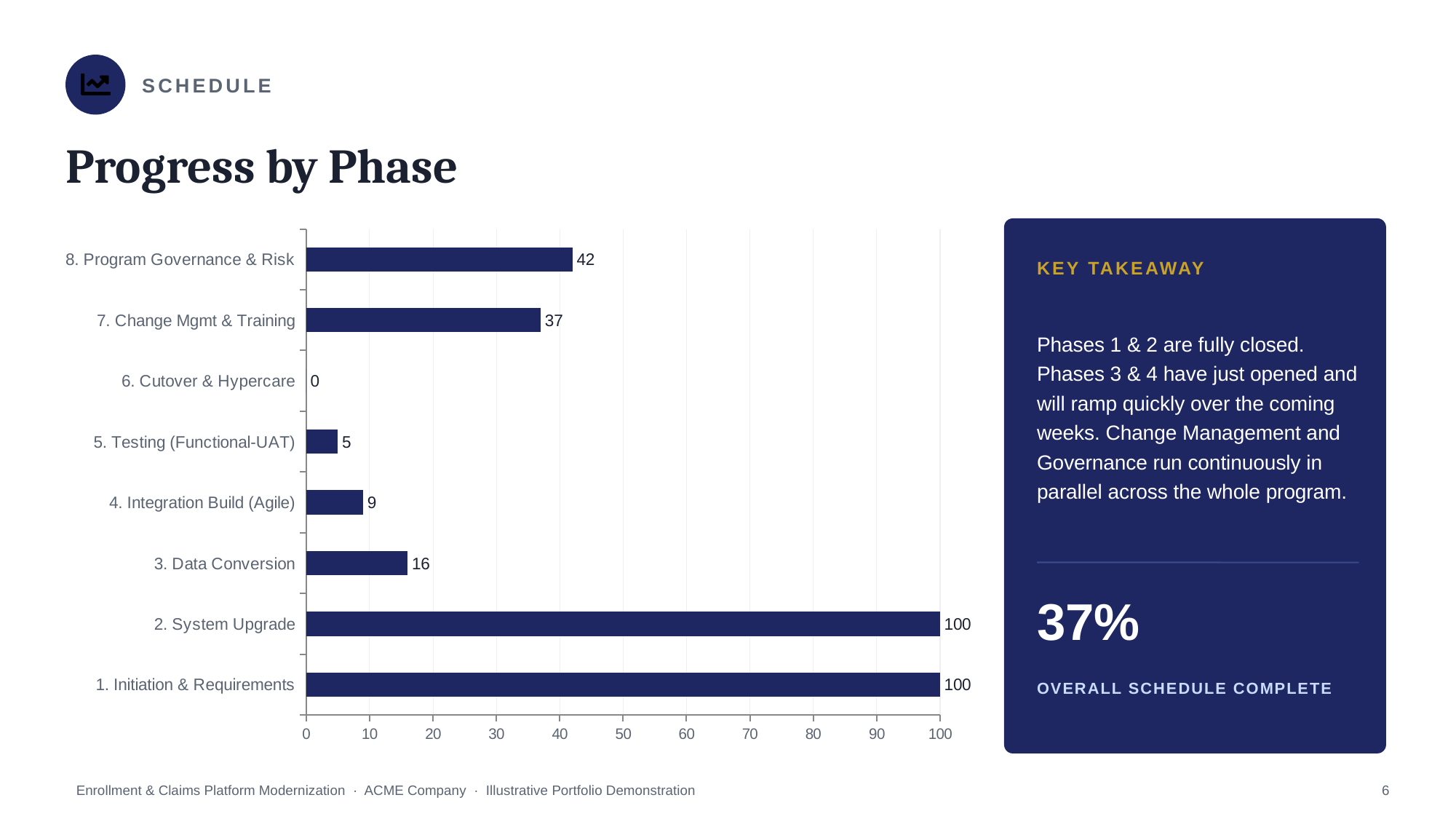
Which phase has the lowest value? 6. Cutover & Hypercare What is the difference between the values for 8. Program Governance & Risk and 7. Change Mgmt & Training? 5 What is the value for 3. Data Conversion? 16 What is the value for 8. Program Governance & Risk? 42 What is the title of the chart? Progress by Phase What kind of chart is shown on the slide? Bar chart What is the value for 5. Testing (Functional-UAT)? 5 Which is larger, the value for 4. Integration Build (Agile) or 5. Testing (Functional-UAT)? 4. Integration Build (Agile) What is the difference between the values for 3. Data Conversion and 4. Integration Build (Agile)? 7 What is the value for 2. System Upgrade? 100 What is the value for 7. Change Mgmt & Training? 37 How many phases are shown in the chart? 8